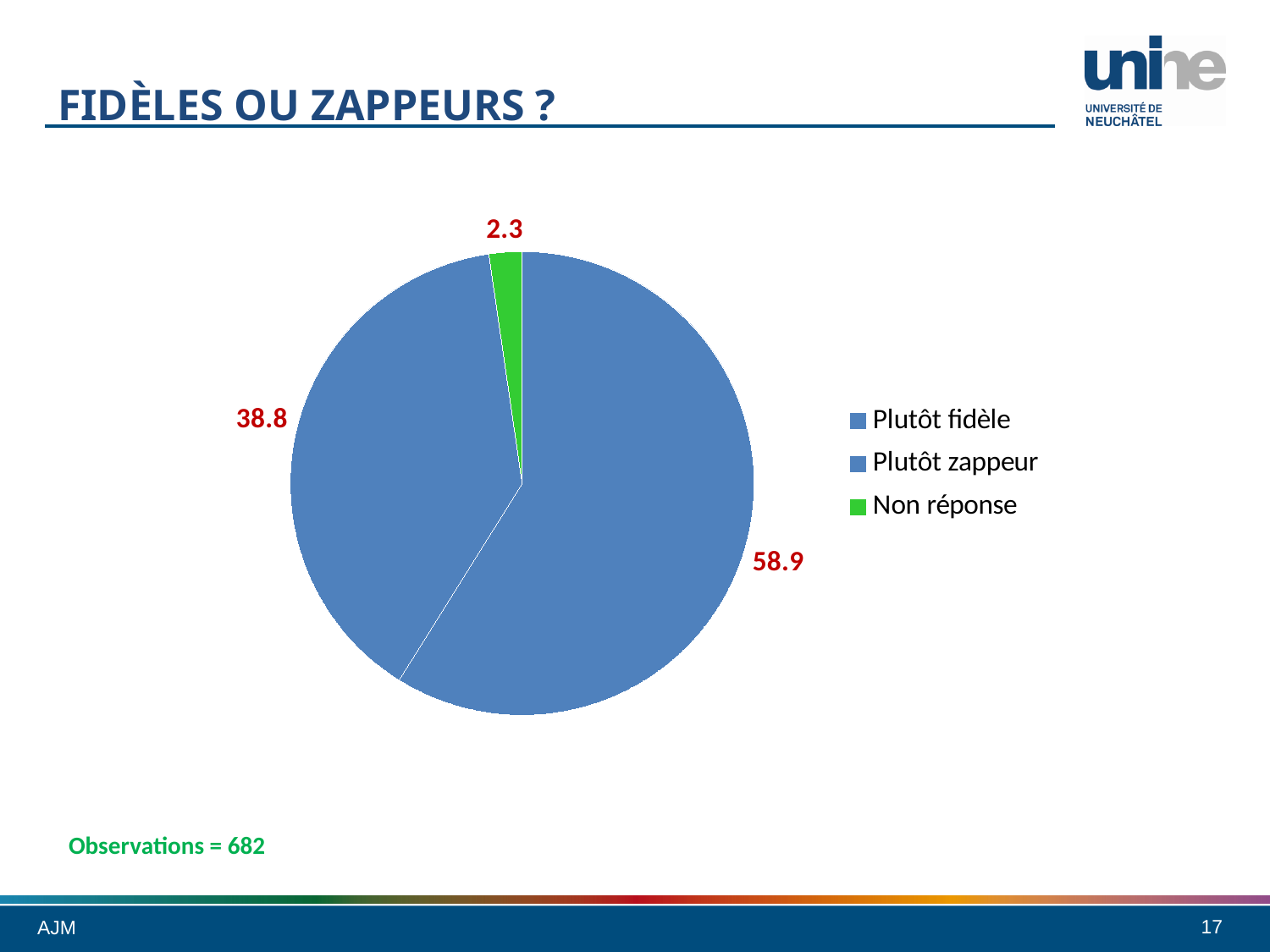
What is the difference between the values for Plutôt fidèle and Plutôt zappeur? 20.1 What is the value shown for Plutôt fidèle? 58.9 Which is larger, the value for Plutôt zappeur or the value for Non réponse? Plutôt zappeur Which category has the smallest slice of the pie? Non réponse What is the value shown for Plutôt zappeur? 38.8 What is the value shown for Non réponse? 2.3 Which category has the largest slice of the pie? Plutôt fidèle What colour is the Non réponse slice? green How many slices does the pie chart have? 3 What is the title of the slide containing the pie chart? FIDÈLES OU ZAPPEURS ? What kind of chart is shown on the slide? pie chart How many entries does the legend list? 3